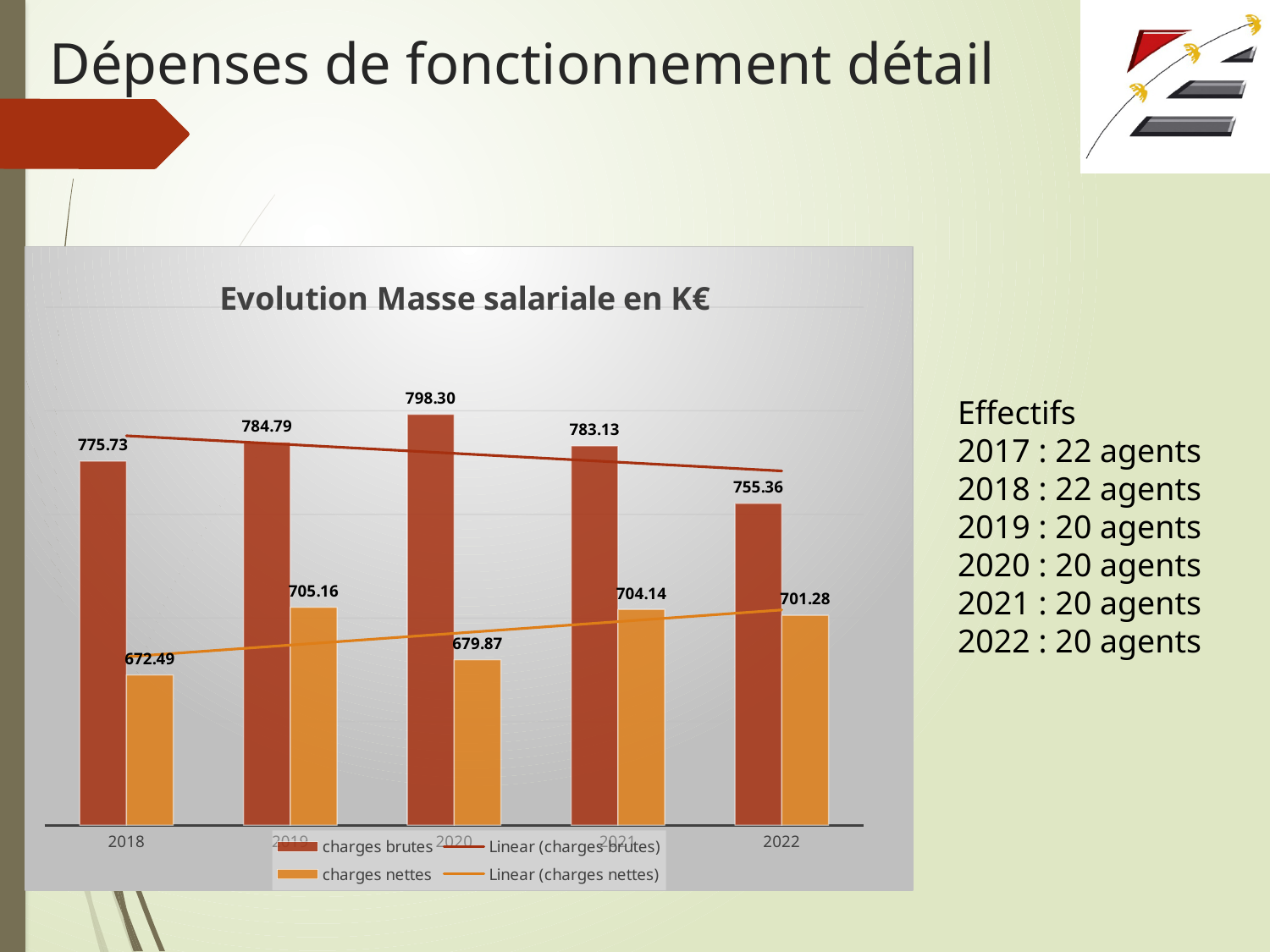
Which is larger: charges nettes in 2019 or charges nettes in 2020? charges nettes in 2019 What is the value of charges brutes for 2020? 798.30 What is the value of charges nettes for 2018? 672.49 What is the title of the chart? Evolution Masse salariale en K€ How many entries does the legend list? 4 In which year are charges brutes lowest? 2022 What is the difference between charges brutes in 2020 and charges brutes in 2022? 42.94 How many years are shown on the x axis? 5 In which year are charges nettes lowest? 2018 What is the value of charges nettes for 2022? 701.28 What is the difference between charges brutes and charges nettes in 2020? 118.43 In which year are charges brutes highest? 2020